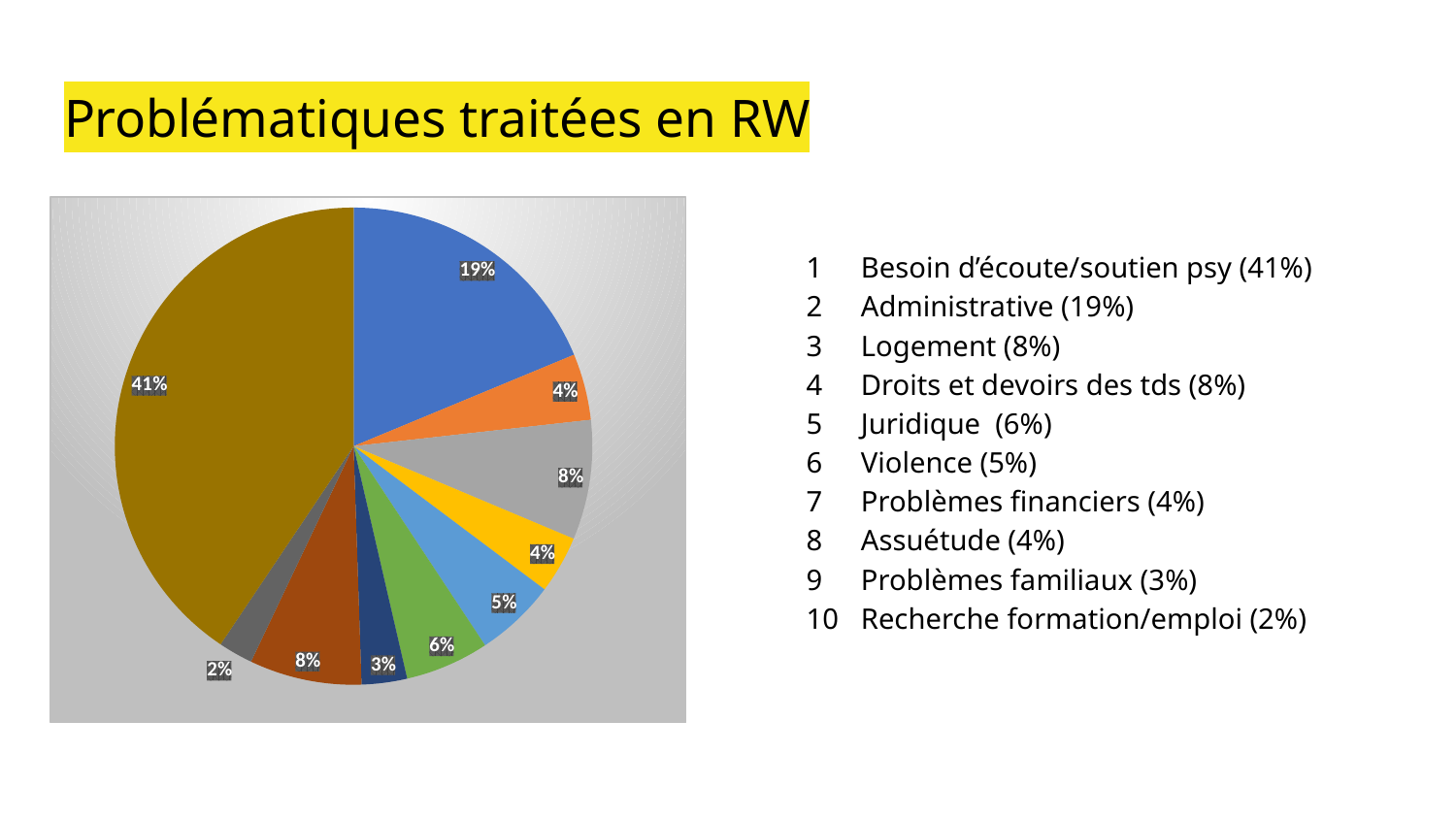
What share of the pie does Problèmes familiaux represent? 3% Which category has the smallest share of the pie? Recherche formation/emploi What share of the pie does Administrative represent? 19% Which is larger, the share for Administrative or the share for Logement? Administrative How many slices does the pie chart have? 10 What is the title of the slide containing the pie chart? Problématiques traitées en RW Which category has the largest share of the pie? Besoin d'écoute/soutien psy What kind of chart is shown on the slide? pie chart What is the difference in percentage points between Besoin d'écoute/soutien psy and Administrative? 22 What percentage of the pie is labelled for the largest slice? 41% What share of the pie does Juridique represent? 6% What share of the pie does Violence represent? 5%